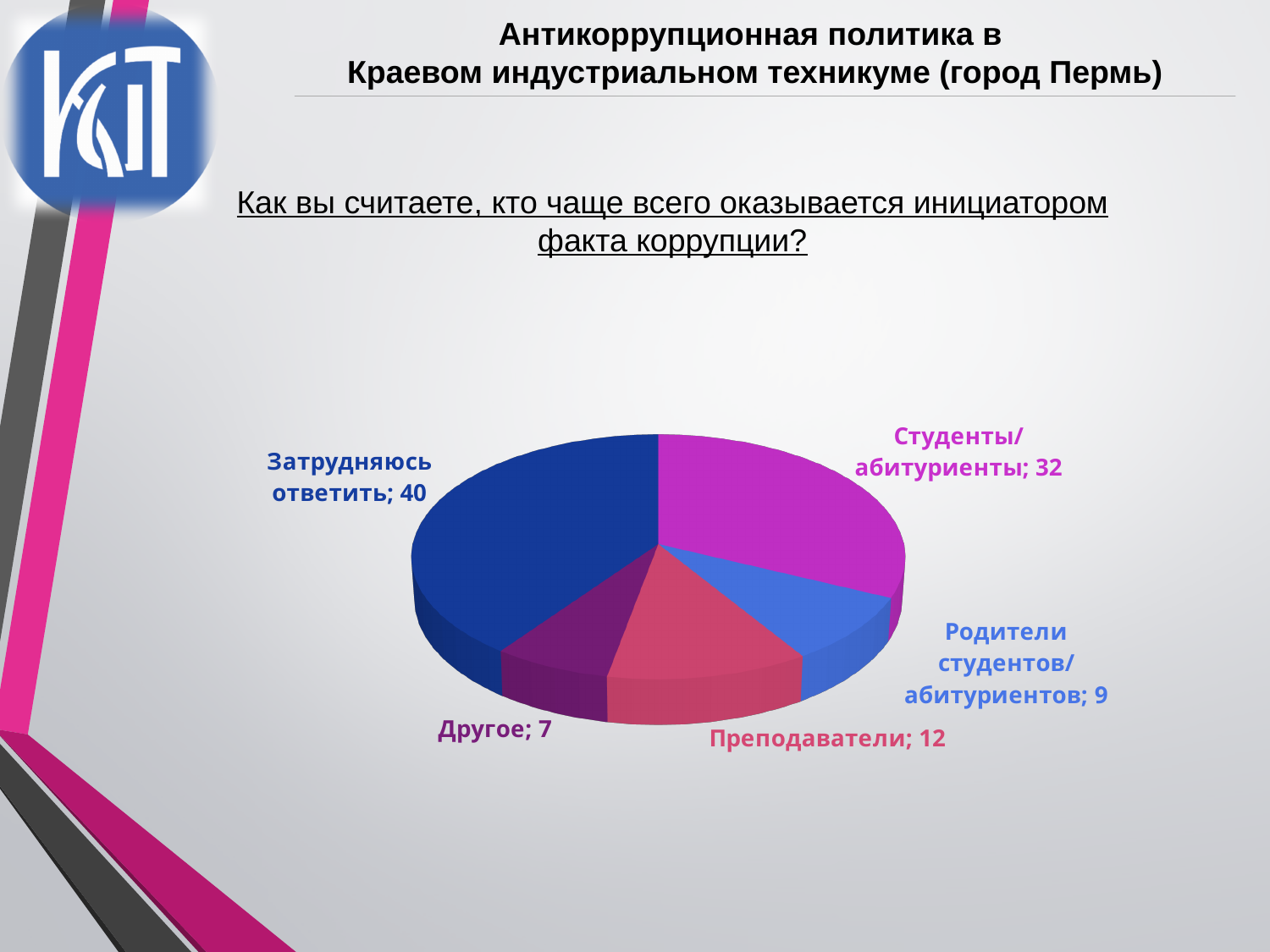
Which category has the largest slice? Затрудняюсь ответить Which category has the smallest slice? Другое What kind of chart is shown on the slide? pie chart What is the value for "Родители студентов/абитуриентов"? 9 How many slices does the pie chart have? 5 Which is larger, the value for "Преподаватели" or the value for "Родители студентов/абитуриентов"? Преподаватели What is the value for "Затрудняюсь ответить"? 40 What is the difference between the values for "Затрудняюсь ответить" and "Студенты/абитуриенты"? 8 What is the total of all the slice values in the pie chart? 100 What share of the pie does "Другое" represent? 7% What is the value for "Студенты/абитуриенты"? 32 What is the value for "Преподаватели"? 12